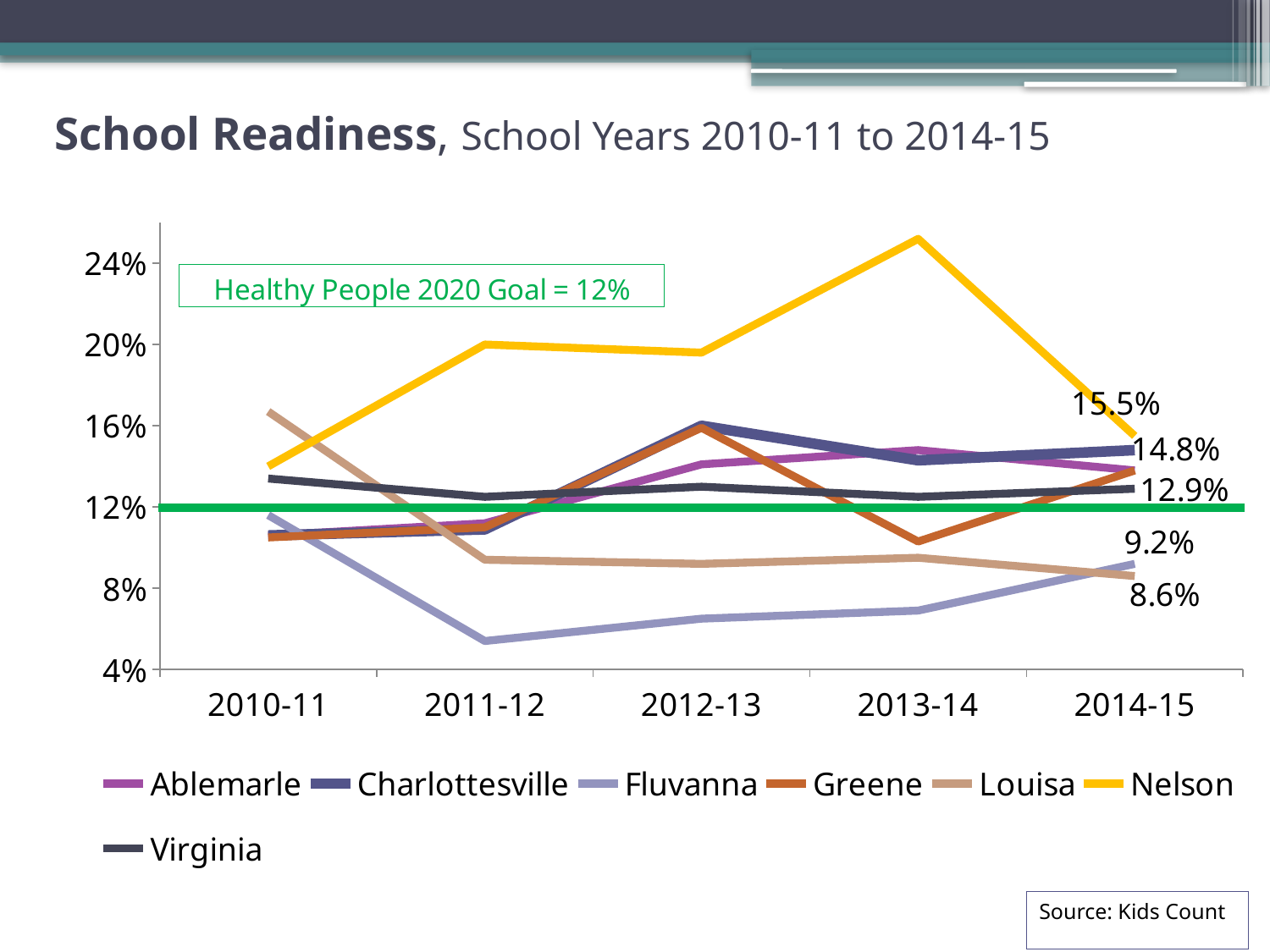
Which locality has the lowest value in 2011-12? Fluvanna Is the value for Fluvanna in 2011-12 greater or less than 8%? less What is the value for Charlottesville in 2014-15? 14.8% Does the value for Nelson rise or fall from 2013-14 to 2014-15? fall What is the value for Virginia in 2014-15? 12.9% What is the Healthy People 2020 Goal shown on the chart? 12% Which locality has the highest value in 2013-14? Nelson What kind of chart is shown on the slide? line chart Is the value for Nelson in 2013-14 greater or less than 24%? greater Which is larger in 2012-13, Nelson or Fluvanna? Nelson How many series does the legend list? 7 How many school years are shown on the x axis? 5